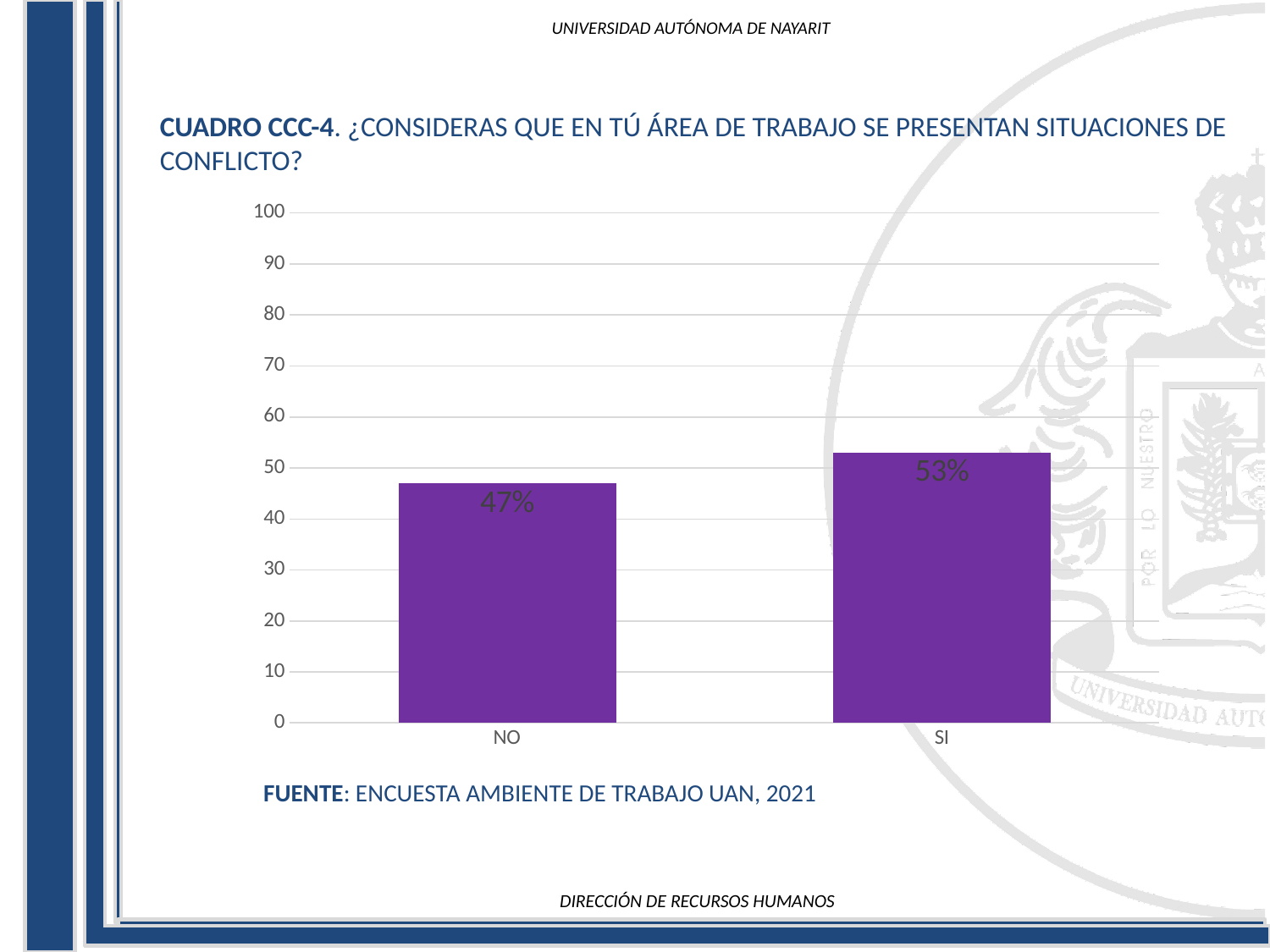
Which is larger, the value for NO or the value for SI? SI What is the value for NO? 47% Which category has the lowest value? NO What kind of chart is shown on the slide? bar chart Is the value for SI greater or less than 50? greater What is the value for SI? 53% Is the value for NO greater or less than 50? less Which category has the highest value? SI How many categories are shown on the x axis? 2 What colour are the bars in the chart? purple What is the difference between the values for SI and NO? 6% What is the maximum value shown on the y axis? 100